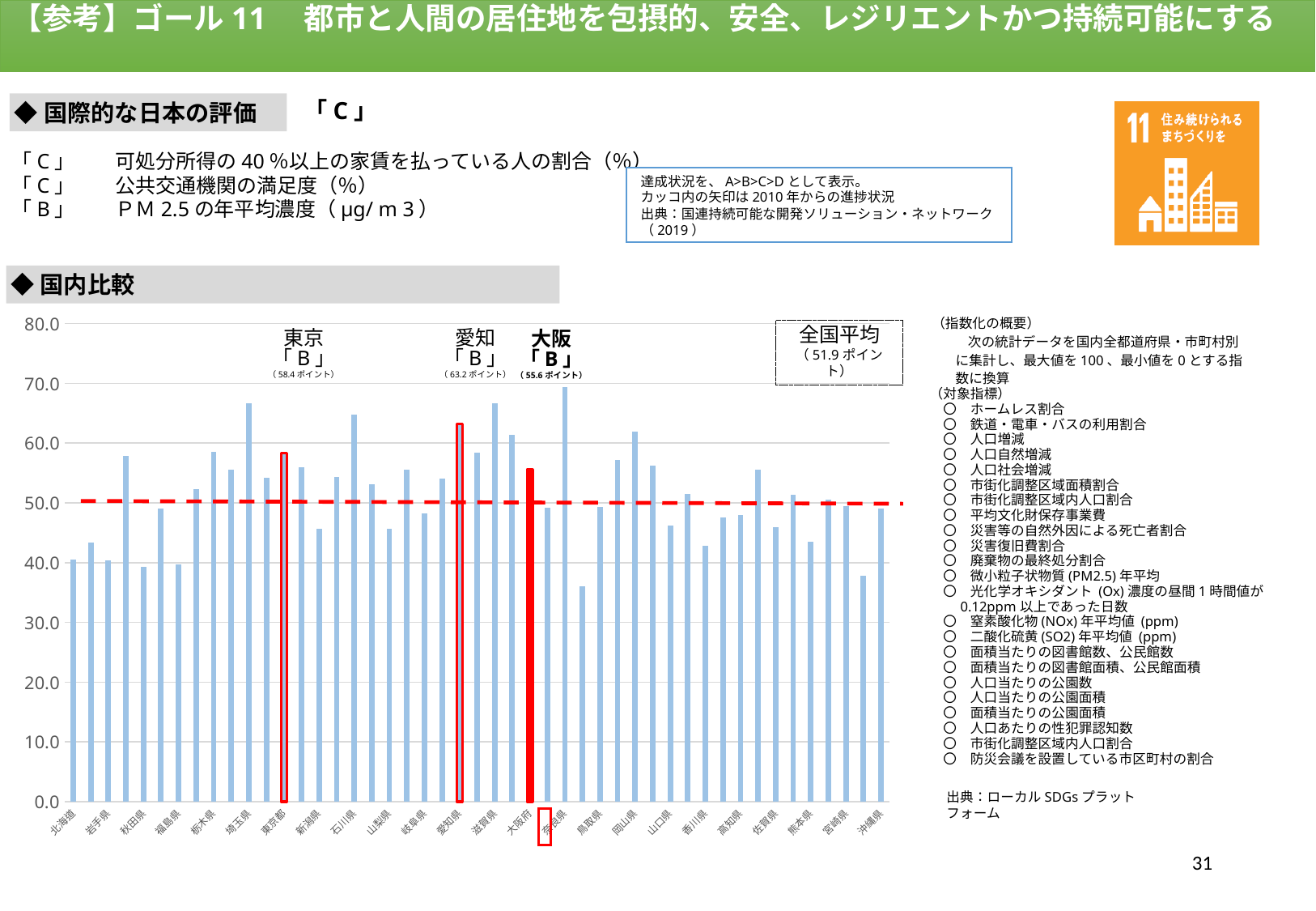
Is the value for 埼玉県 greater or less than 60.0? greater What value is printed for 愛知 on the chart? 63.2 ポイント Is the value for 北海道 greater or less than 50.0? less What value is printed for 大阪 on the chart? 55.6 ポイント What kind of chart is shown under 国内比較? bar chart What value is printed for 東京 on the chart? 58.4 ポイント Is the value for 大阪 greater or less than the 全国平均? greater What is the difference between the values for 東京 and 大阪? 2.8 ポイント What is the 全国平均 value shown on the chart? 51.9 ポイント Which has the larger value, 東京 or 愛知? 愛知 What is the difference between the values for 愛知 and 東京? 4.8 ポイント